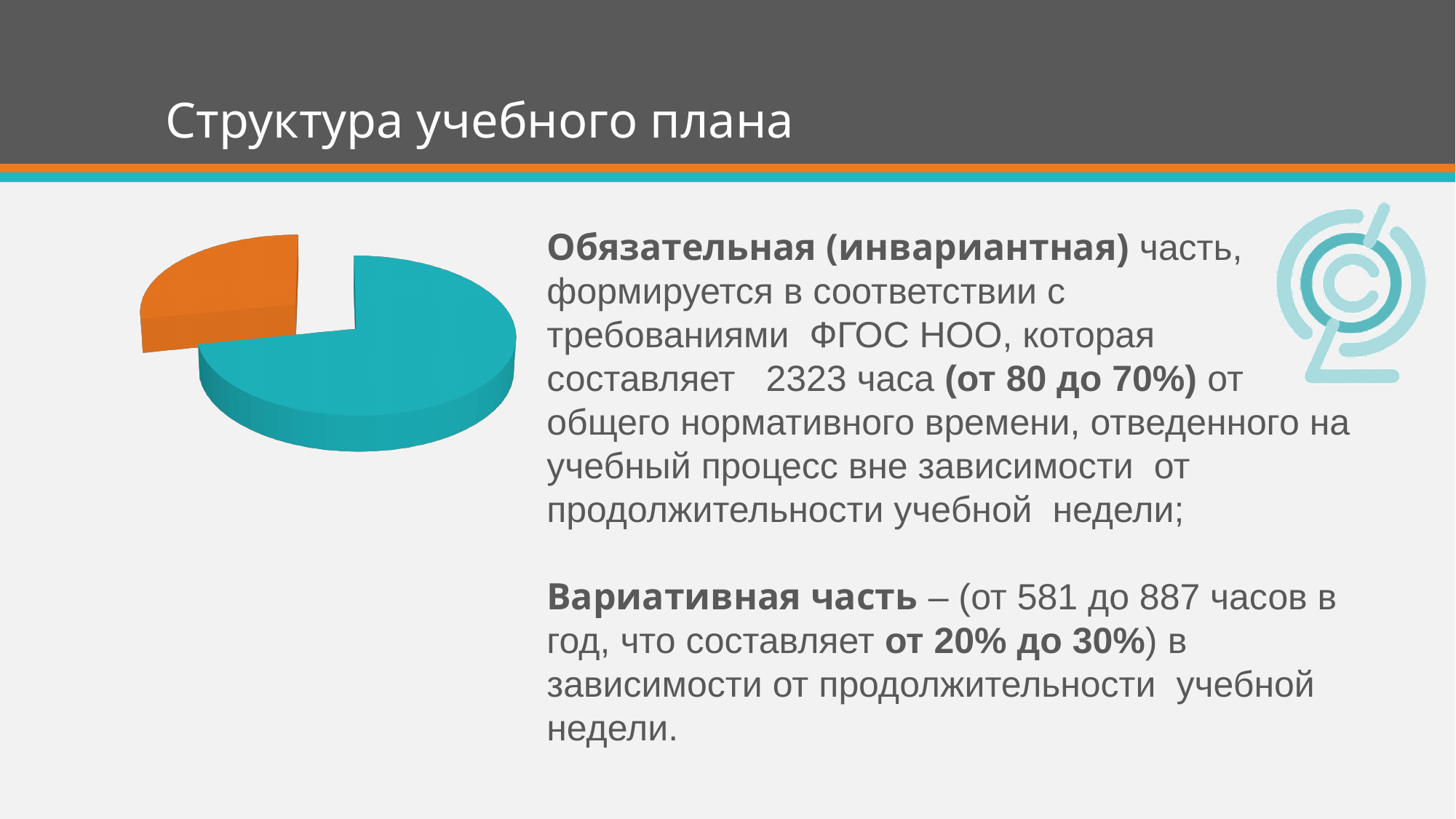
How many slices does the pie chart have? 2 Which slice of the pie chart is larger, the teal one or the orange one? the teal one Does the pie chart display a legend? no What kind of chart is shown on the slide? pie chart Which colour slice takes up the largest share of the pie chart? teal Is the teal slice of the pie chart more or less than half of the pie? more Which colour slice takes up the smallest share of the pie chart? orange What two colours are used for the slices of the pie chart? teal and orange